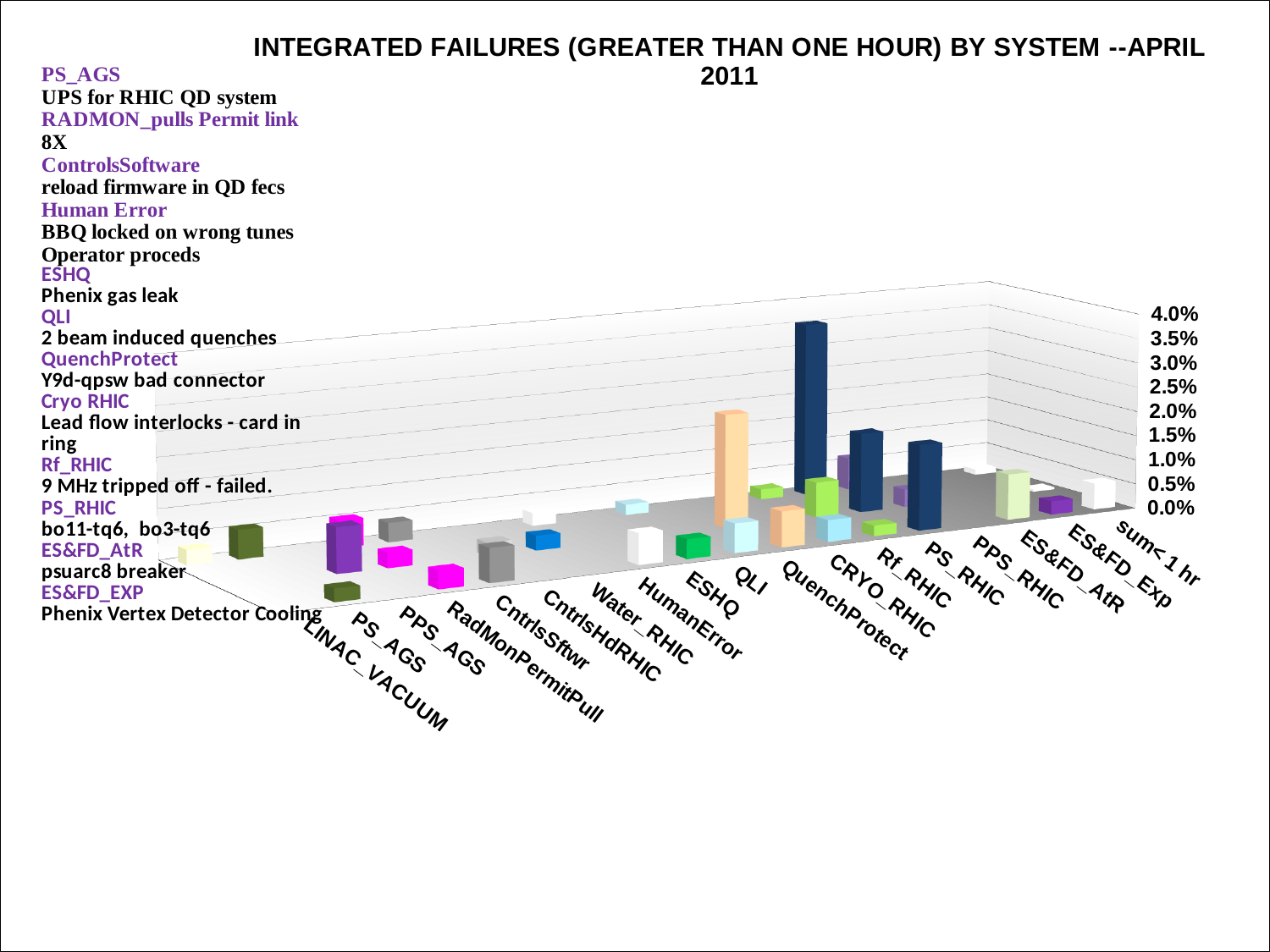
What is the first category label on the x axis? LINAC_VACUUM Is the value for LINAC_VACUUM greater or less than 1.0%? less What kind of chart is shown on the slide? bar chart Which system has the tallest bar in the chart? PS_RHIC What is the last category label on the x axis? sum< 1 hr What is the title of the chart? INTEGRATED FAILURES (GREATER THAN ONE HOUR) BY SYSTEM --APRIL 2011 What is the highest value shown on the vertical axis? 4.0% Is the tallest bar for QLI greater or less than 2.0%? less How many system categories are labelled along the x axis of the chart? 18